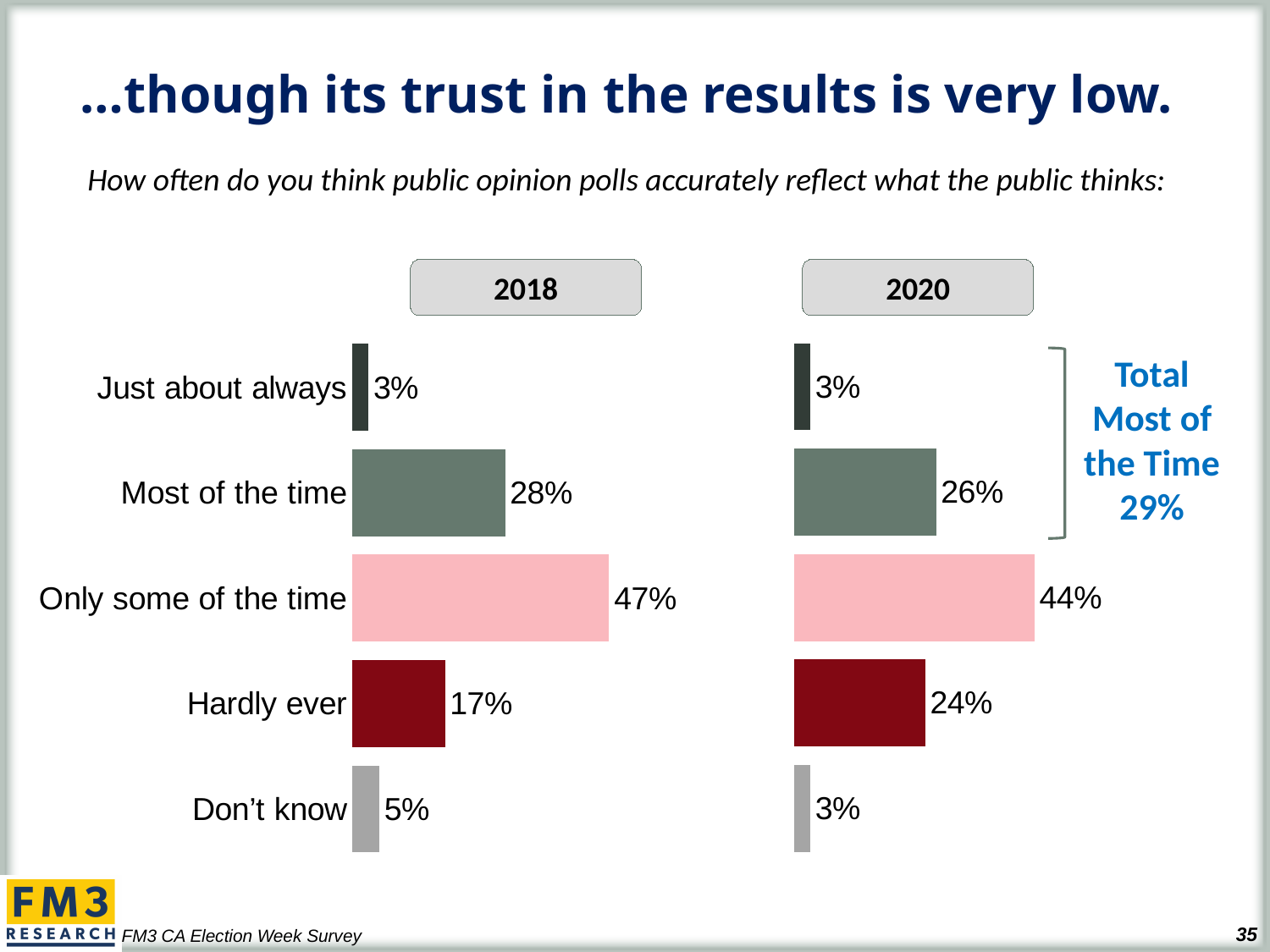
What is the difference between the 'Hardly ever' percentages in 2020 and 2018? 7 percentage points In the 2020 chart, what percentage said 'Hardly ever'? 24% Which is larger: 'Most of the time' in 2018 or 'Most of the time' in 2020? 2018 What type of chart is used on this slide? Bar chart In the 2018 chart, what percentage said 'Don't know'? 5% How many response categories are shown in each chart? 5 In the 2020 chart, which response category has the lowest percentage? Just about always and Don't know (both 3%) In the 2020 chart, what percentage said 'Most of the time'? 26% In the 2018 chart, which response category has the highest percentage? Only some of the time In the 2018 chart, what percentage said polls accurately reflect public opinion 'Only some of the time'? 47% What is the difference between 'Only some of the time' in 2018 and 2020? 3 percentage points What is the 'Total Most of the Time' figure shown for 2020? 29%